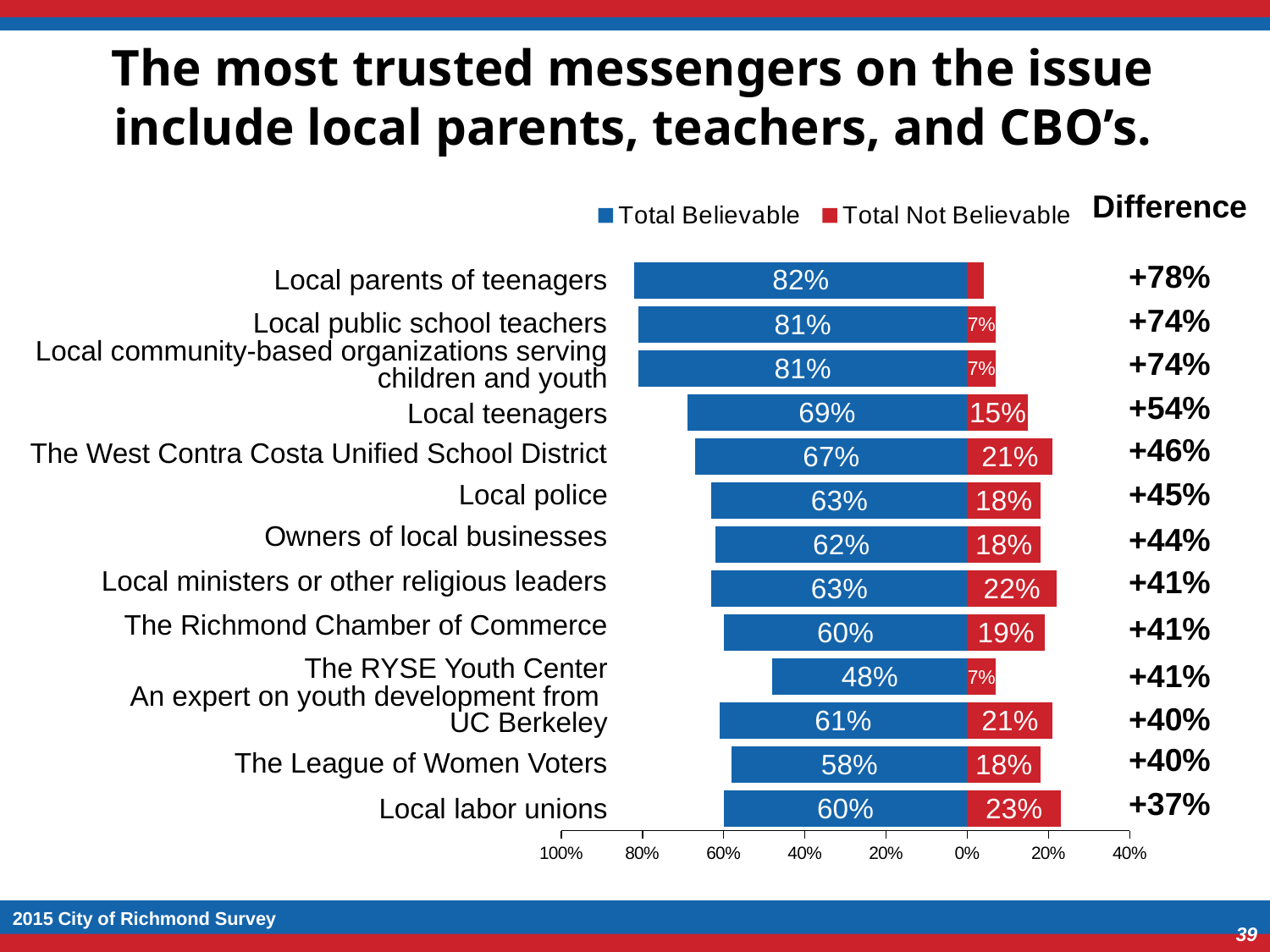
How many series does the legend list? 2 Which messenger has the highest Total Believable value? Local parents of teenagers Which has a larger Total Not Believable value, local police or local ministers or other religious leaders? Local ministers or other religious leaders What kind of chart is shown on the slide? Bar chart What is the Total Not Believable value for local labor unions? 23% Which messenger has the highest Total Not Believable value? Local labor unions What is the difference between the Total Believable values for local teenagers and The League of Women Voters? 11% What is the Difference value shown for The West Contra Costa Unified School District? +46% Which messenger has the lowest Total Believable value? The RYSE Youth Center What is the Total Believable value for The RYSE Youth Center? 48% How many messengers are listed in the chart? 13 What percentage of respondents found local parents of teenagers believable? 82%